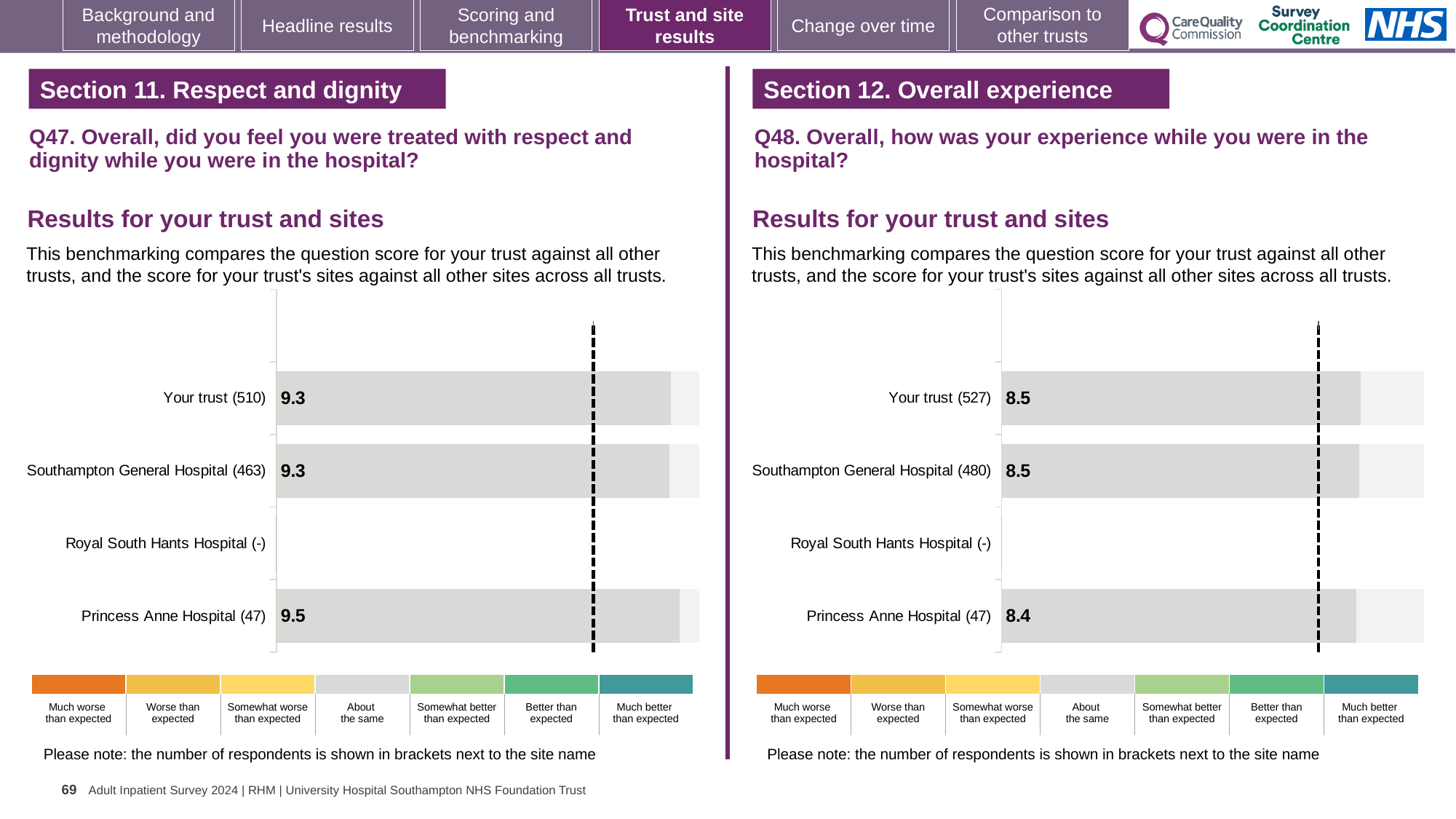
How many site/trust rows are listed on the Q47 chart (Section 11, left)? 4 On the Q47 chart (Section 11, left), which site has no score shown? Royal South Hants Hospital On the Q48 chart (Section 12, right), which is larger: the score for Southampton General Hospital or the score for Princess Anne Hospital? Southampton General Hospital On the Q47 chart (Section 11, left), what is the score for Your trust? 9.3 On the Q47 chart (Section 11, left), what is the difference between the Princess Anne Hospital score and the Southampton General Hospital score? 0.2 On the Q47 chart (Section 11, left), which site has the highest score? Princess Anne Hospital On the Q47 chart (Section 11, left), what is the score for Princess Anne Hospital? 9.5 How many respondents are shown in brackets for Your trust on the Q48 chart (Section 12, right)? 527 What kind of chart is used on the Q47 chart (Section 11, left)? Bar chart On the Q48 chart (Section 12, right), what is the score for Princess Anne Hospital? 8.4 On the Q48 chart (Section 12, right), what is the score for Your trust? 8.5 On the Q48 chart (Section 12, right), what is the difference between the Your trust score and the Princess Anne Hospital score? 0.1